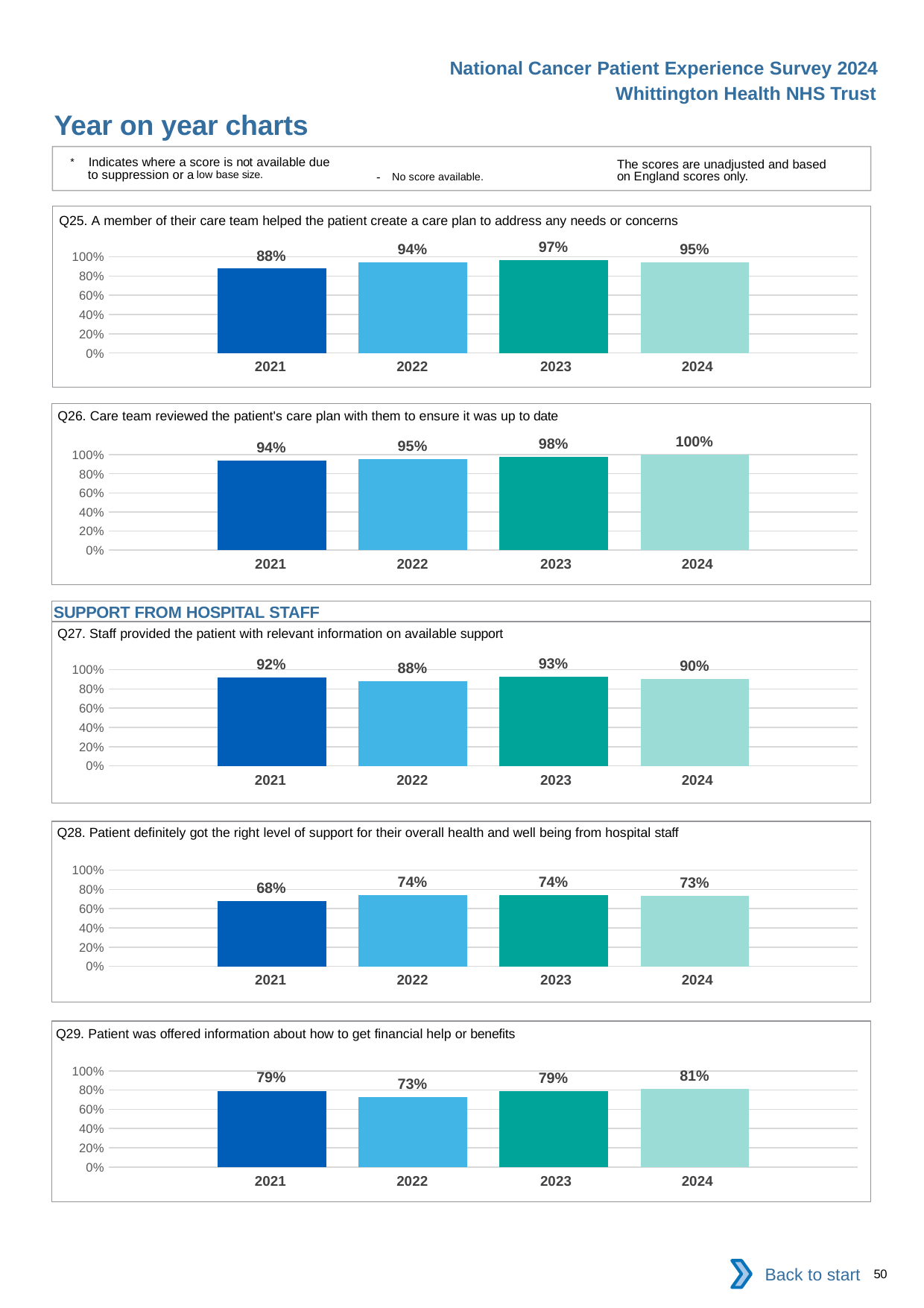
In the Q29 chart, which year has the lowest value? 2022 In the Q25 chart, what is the value for 2023? 97% In the Q28 chart, what is the difference between the 2022 and 2021 values? 6% In the Q27 chart, which year has the highest value? 2023 How many years are shown in the Q29 chart? 4 In the Q27 chart, which is larger, the value for 2021 or the value for 2022? 2021 In the Q26 chart, what is the value for 2024? 100% What type of chart is the Q25 chart? bar chart In the Q25 chart, which year has the lowest value? 2021 In the Q28 chart, what is the value for 2021? 68% In the Q26 chart, do the values rise or fall from 2021 to 2024? rise In the Q26 chart, what is the difference between the 2024 and 2021 values? 6%